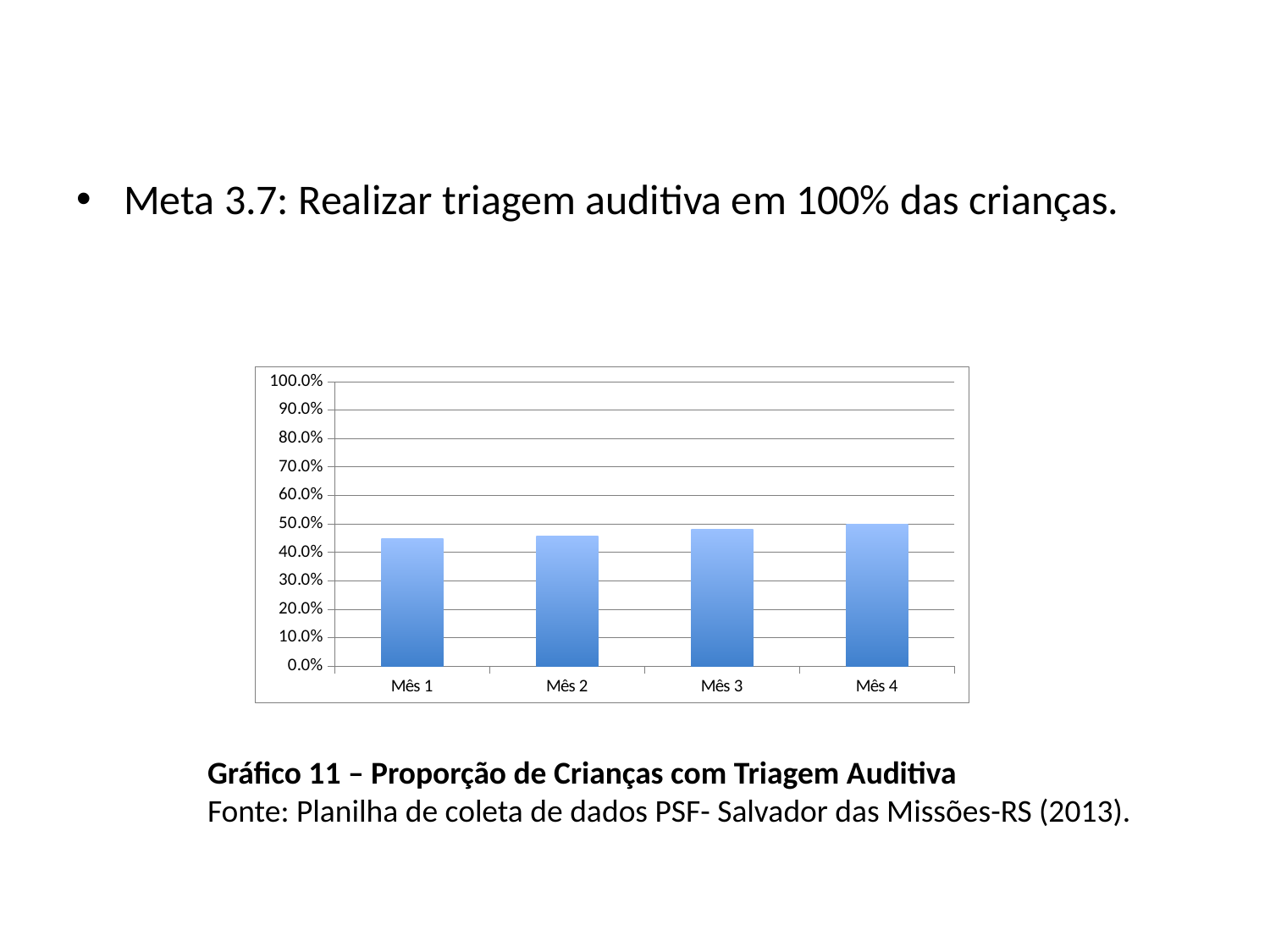
How many categories (months) are plotted on the chart? 4 What is the maximum value shown on the vertical axis of the chart? 100.0% Do the values rise or fall from Mês 1 to Mês 4? rise Which is larger, the value for Mês 1 or the value for Mês 4? Mês 4 Is the value for Mês 1 greater or less than 40.0%? greater What is the title given for the chart (Gráfico 11)? Proporção de Crianças com Triagem Auditiva Is the value for Mês 1 greater or less than 50.0%? less What kind of chart is shown on the slide? Bar chart Is the value for Mês 2 greater or less than 60.0%? less Which month has the highest bar on the chart? Mês 4